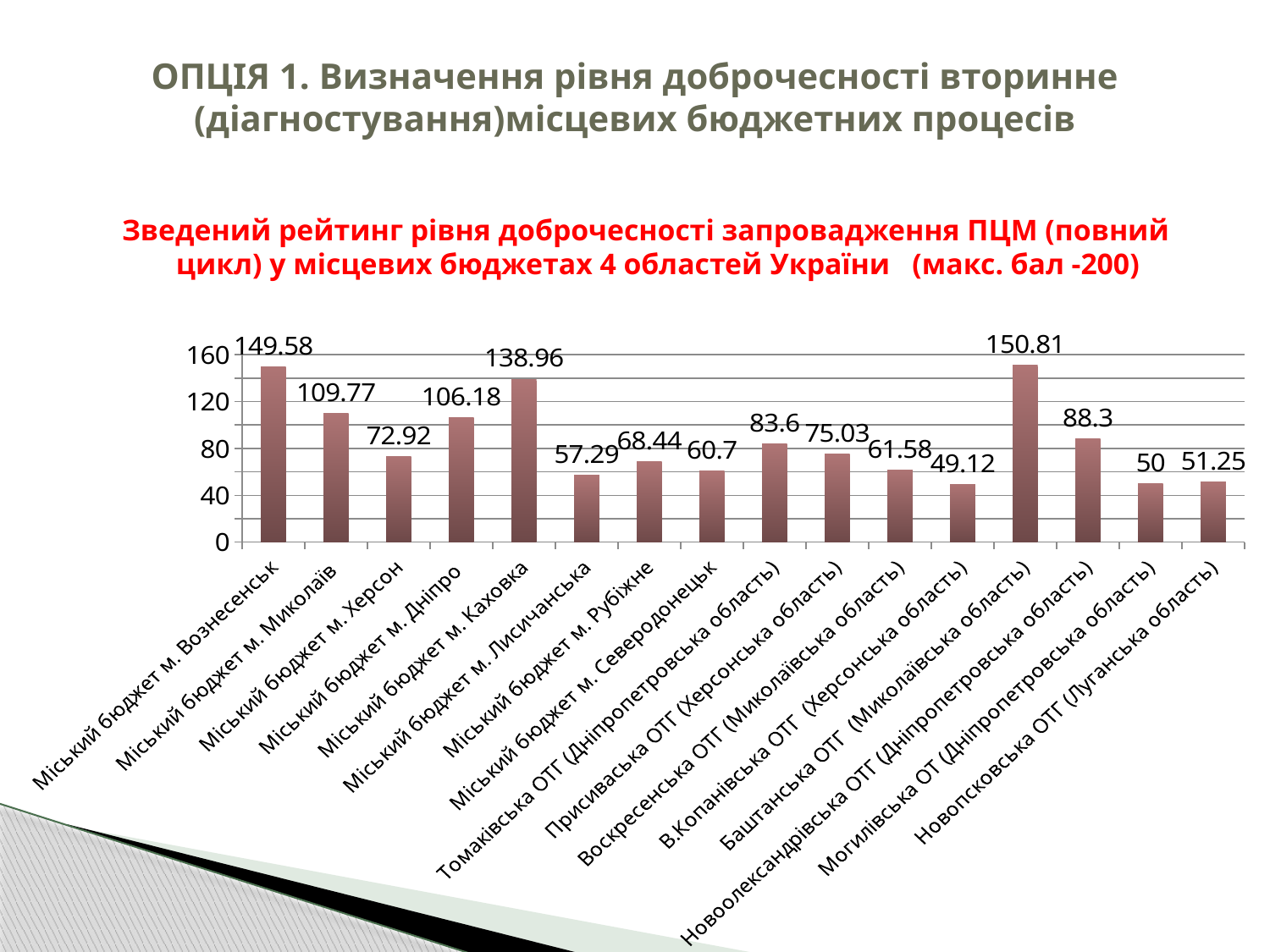
What is the value for Могилівська ОТ (Дніпропетровська область)? 50 Which is larger: the value for Міський бюджет м. Херсон or the value for Присиваська ОТГ (Херсонська область)? Присиваська ОТГ (Херсонська область) Which category has the lowest value in the chart? В.Копанівська ОТГ (Херсонська область) How many categories (local budgets) are plotted in the chart? 16 What type of chart is shown on the slide? bar chart What is the value for Томаківська ОТГ (Дніпропетровська область)? 83.6 What is the value for Міський бюджет м. Вознесенськ? 149.58 Is the value for Новоолександрівська ОТГ (Дніпропетровська область) greater or less than 80? greater Which category has the highest value in the chart? Баштанська ОТГ (Миколаївська область) What is the value for Міський бюджет м. Каховка? 138.96 What is the difference between the values for Міський бюджет м. Миколаїв and Міський бюджет м. Дніпро? 3.59 What maximum score is stated in the chart's title? 200